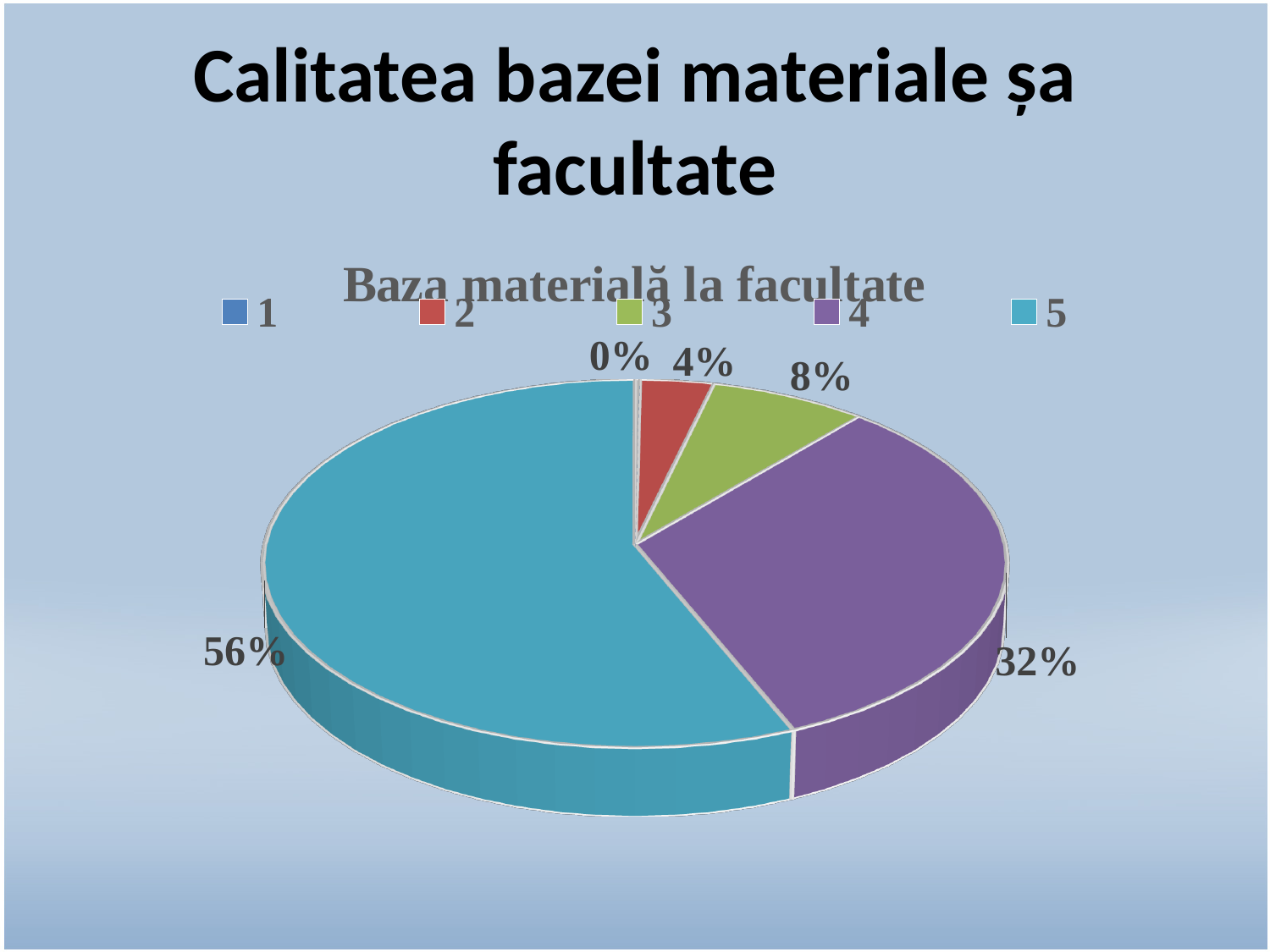
What percentage is shown for category 5? 56% Which category has the smallest share of the pie? 1 What type of chart is shown on the slide? Pie chart Which is larger, the share for category 3 or the share for category 2? 3 How many categories does the legend list? 5 Which category has the largest share of the pie? 5 What percentage is shown for category 3? 8% What percentage is shown for category 2? 4% What is the difference between the shares of category 5 and category 4? 24% What is the title of the chart? Baza materială la facultate What percentage is shown for category 4? 32% What percentage is shown for category 1? 0%